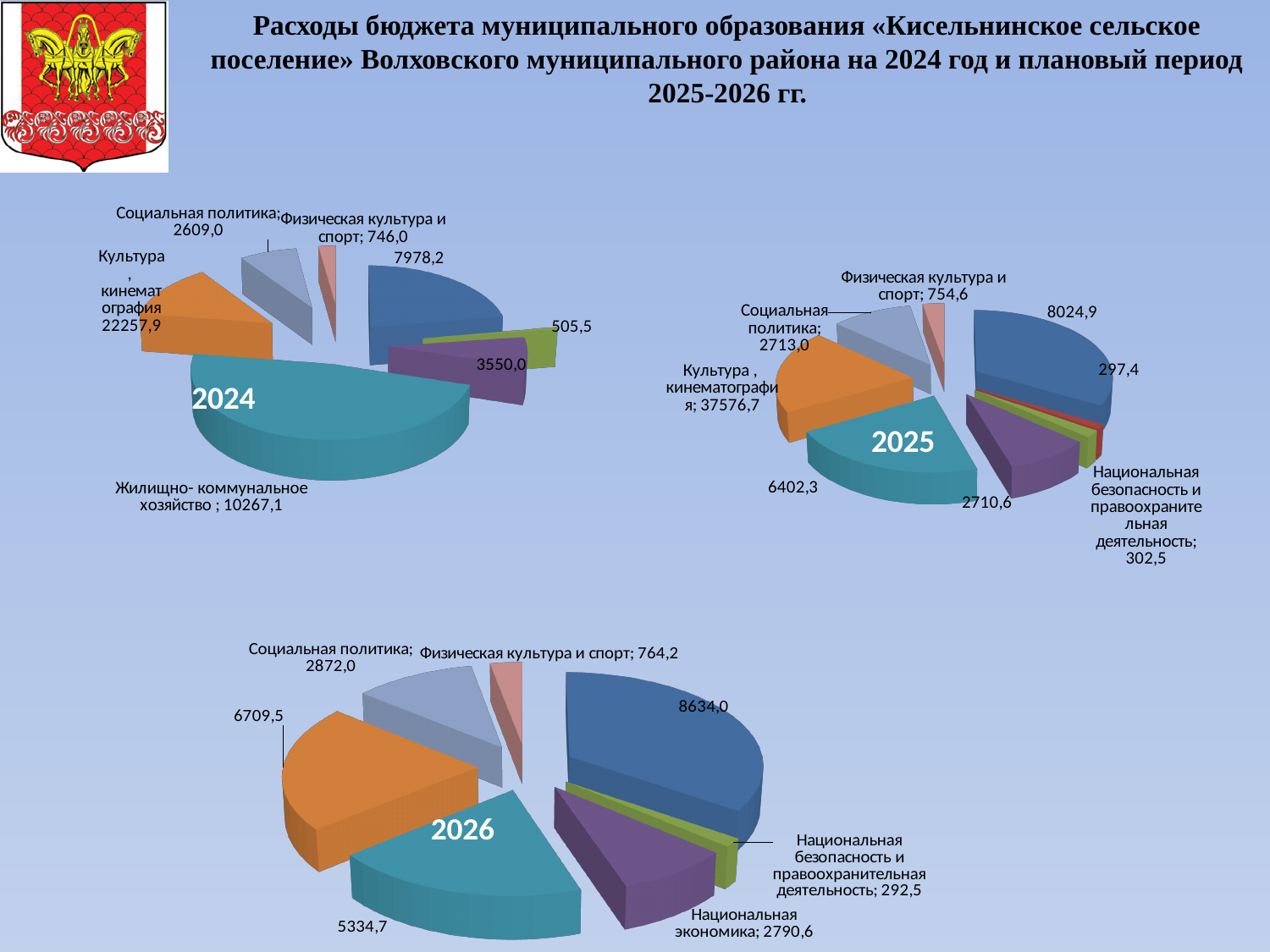
In the 2024 chart, what is the value for Жилищно-коммунальное хозяйство? 10267,1 In the 2025 chart, what is the value for Национальная безопасность и правоохранительная деятельность? 302,5 What type of chart is used for the 2024 budget expenditures? Pie chart In the 2026 chart, what is the value for Национальная экономика? 2790,6 In the 2026 chart, what is the value for Физическая культура и спорт? 764,2 In the 2024 chart, what is the value for Культура, кинематография? 22257,9 In the 2025 chart, which is larger: Социальная политика or Физическая культура и спорт? Социальная политика What is the value of the largest slice in the 2026 chart? 8634,0 In the 2025 chart, what is the value for Социальная политика? 2713,0 How many slices does the 2024 pie chart have? 7 In the 2026 chart, what is the difference between Социальная политика and Национальная экономика? 81,4